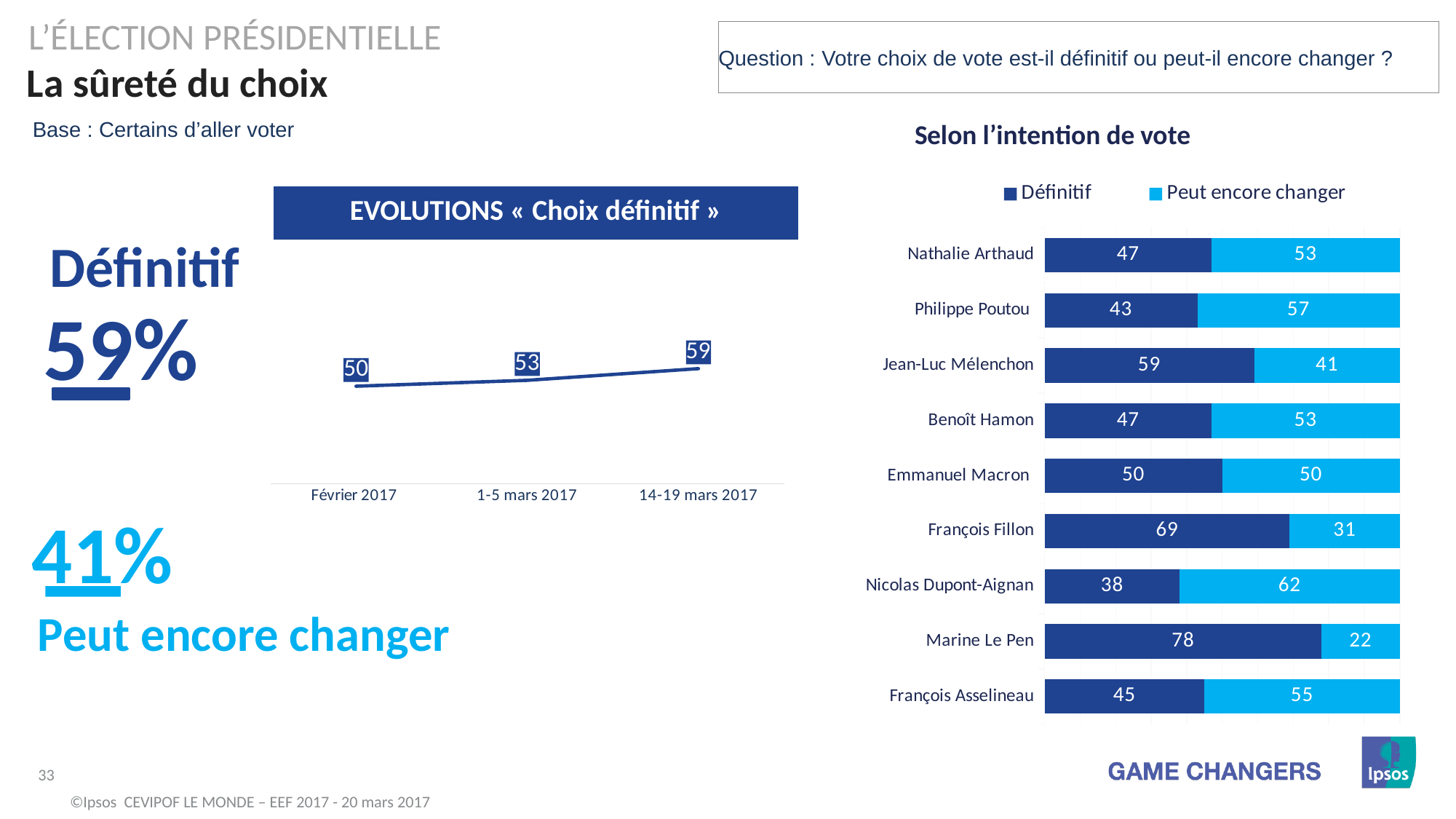
In the 'Selon l'intention de vote' chart, which candidate has the lowest 'Définitif' value? Nicolas Dupont-Aignan In the 'EVOLUTIONS « Choix définitif »' chart, what is the value for 14-19 mars 2017? 59 In the 'Selon l'intention de vote' chart, which candidate has the highest 'Définitif' value? Marine Le Pen In the 'Selon l'intention de vote' chart, what is the 'Peut encore changer' value for Nicolas Dupont-Aignan? 62 What kind of chart is the 'EVOLUTIONS « Choix définitif »' chart? line chart In the 'EVOLUTIONS « Choix définitif »' chart, do the values rise or fall from Février 2017 to 14-19 mars 2017? rise In the 'Selon l'intention de vote' chart, what is the 'Définitif' value for Marine Le Pen? 78 In the 'EVOLUTIONS « Choix définitif »' chart, what is the value for Février 2017? 50 In the 'Selon l'intention de vote' chart, what is the difference between the 'Définitif' values for François Fillon and Jean-Luc Mélenchon? 10 In the 'Selon l'intention de vote' chart, how many series does the legend list? 2 In the 'Selon l'intention de vote' chart, how many candidates are shown? 9 In the 'EVOLUTIONS « Choix définitif »' chart, how many data points are plotted? 3